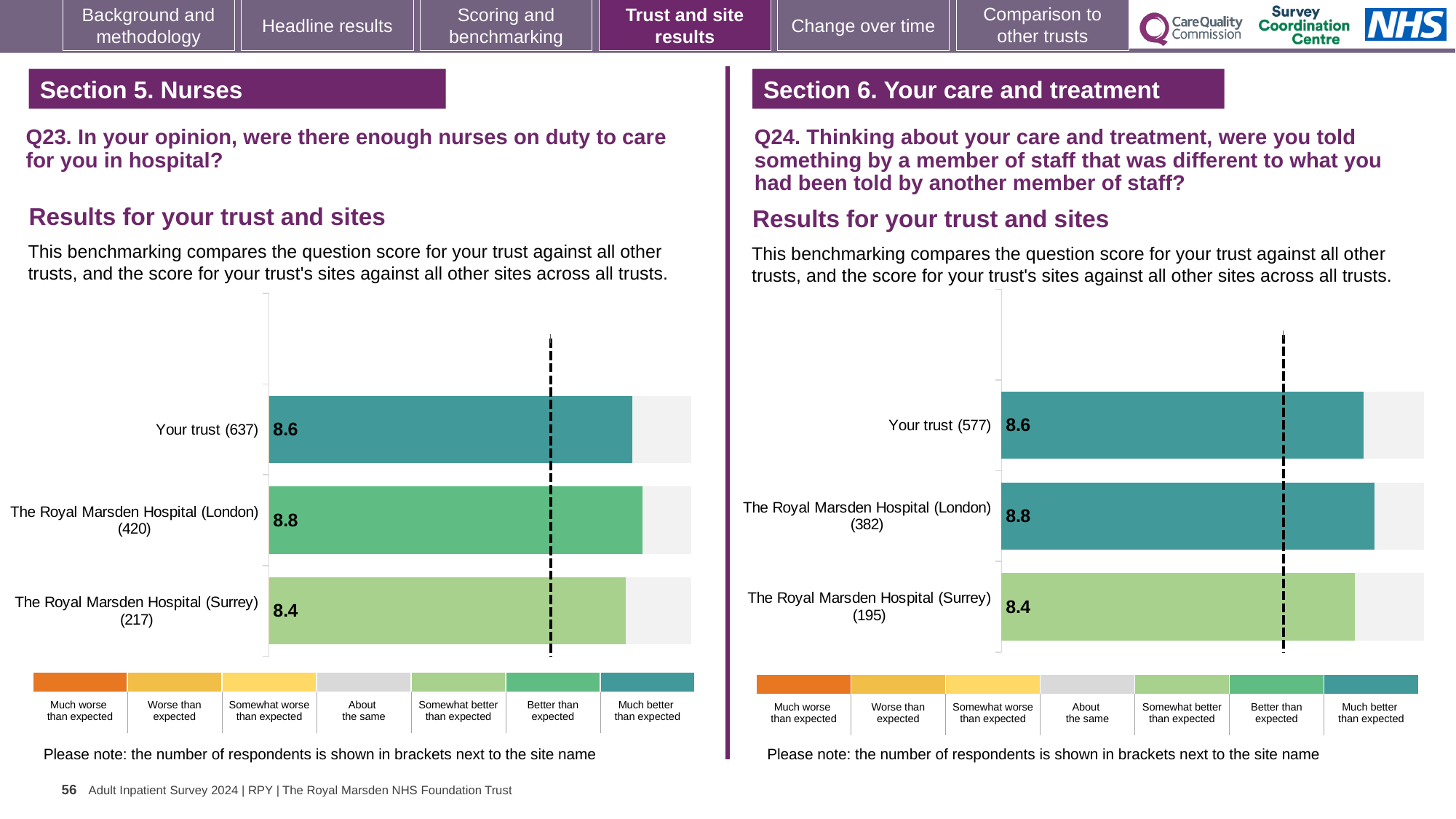
On the Q24 chart (right), what is the score for The Royal Marsden Hospital (London)? 8.8 On the Q23 chart (left), how many respondents are shown in brackets for The Royal Marsden Hospital (London)? 420 On the Q23 chart (left), what is the score for The Royal Marsden Hospital (Surrey)? 8.4 On the Q23 chart (left), what is the score for Your trust? 8.6 How many bars are plotted on the Q24 chart (right)? 3 On the Q24 chart (right), which is larger: the score for Your trust or the score for The Royal Marsden Hospital (Surrey)? Your trust On the Q24 chart (right), how many respondents are shown in brackets for Your trust? 577 What type of chart is used for the Q23 results (left)? Bar chart On the Q23 chart (left), which site or trust has the highest score? The Royal Marsden Hospital (London) On the Q24 chart (right), which site or trust has the lowest score? The Royal Marsden Hospital (Surrey) On the Q23 chart (left), what is the difference between the scores for The Royal Marsden Hospital (London) and The Royal Marsden Hospital (Surrey)? 0.4 On the Q24 chart (right), what is the difference between the scores for Your trust and The Royal Marsden Hospital (London)? 0.2